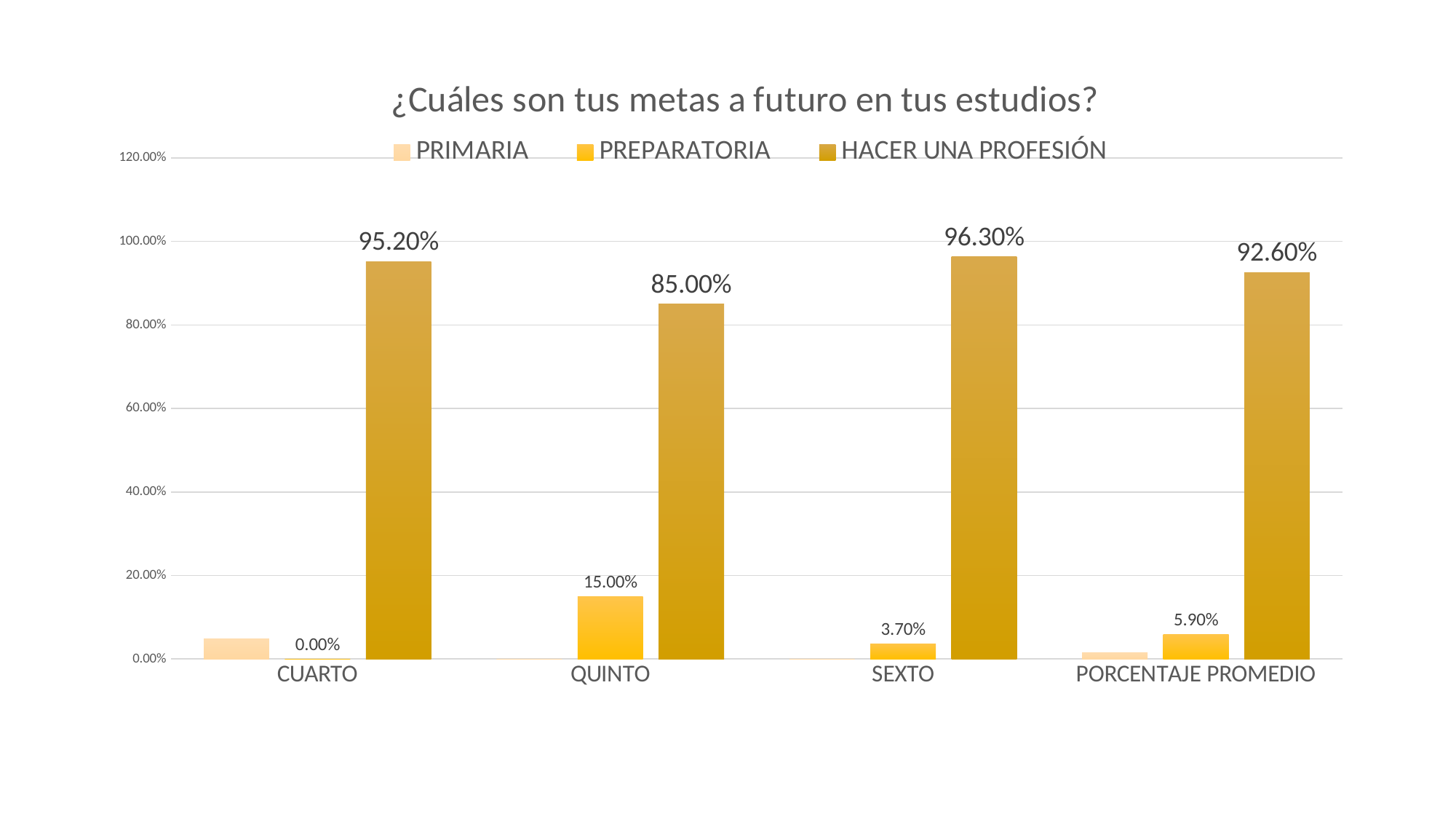
What kind of chart is shown on the slide? bar chart What is the value for PREPARATORIA in the PORCENTAJE PROMEDIO category? 5.90% For HACER UNA PROFESIÓN, which is larger: CUARTO or PORCENTAJE PROMEDIO? CUARTO Which category has the highest value for HACER UNA PROFESIÓN? SEXTO How many categories are shown on the x axis? 4 How many series does the legend list? 3 What is the value for HACER UNA PROFESIÓN in the QUINTO category? 85.00% What is the value for PREPARATORIA in the QUINTO category? 15.00% Is the value for PRIMARIA in the CUARTO category greater or less than 20.00%? less What is the difference between the HACER UNA PROFESIÓN values for SEXTO and QUINTO? 11.30% What is the value for HACER UNA PROFESIÓN in the SEXTO category? 96.30% Which category has the lowest value for HACER UNA PROFESIÓN? QUINTO